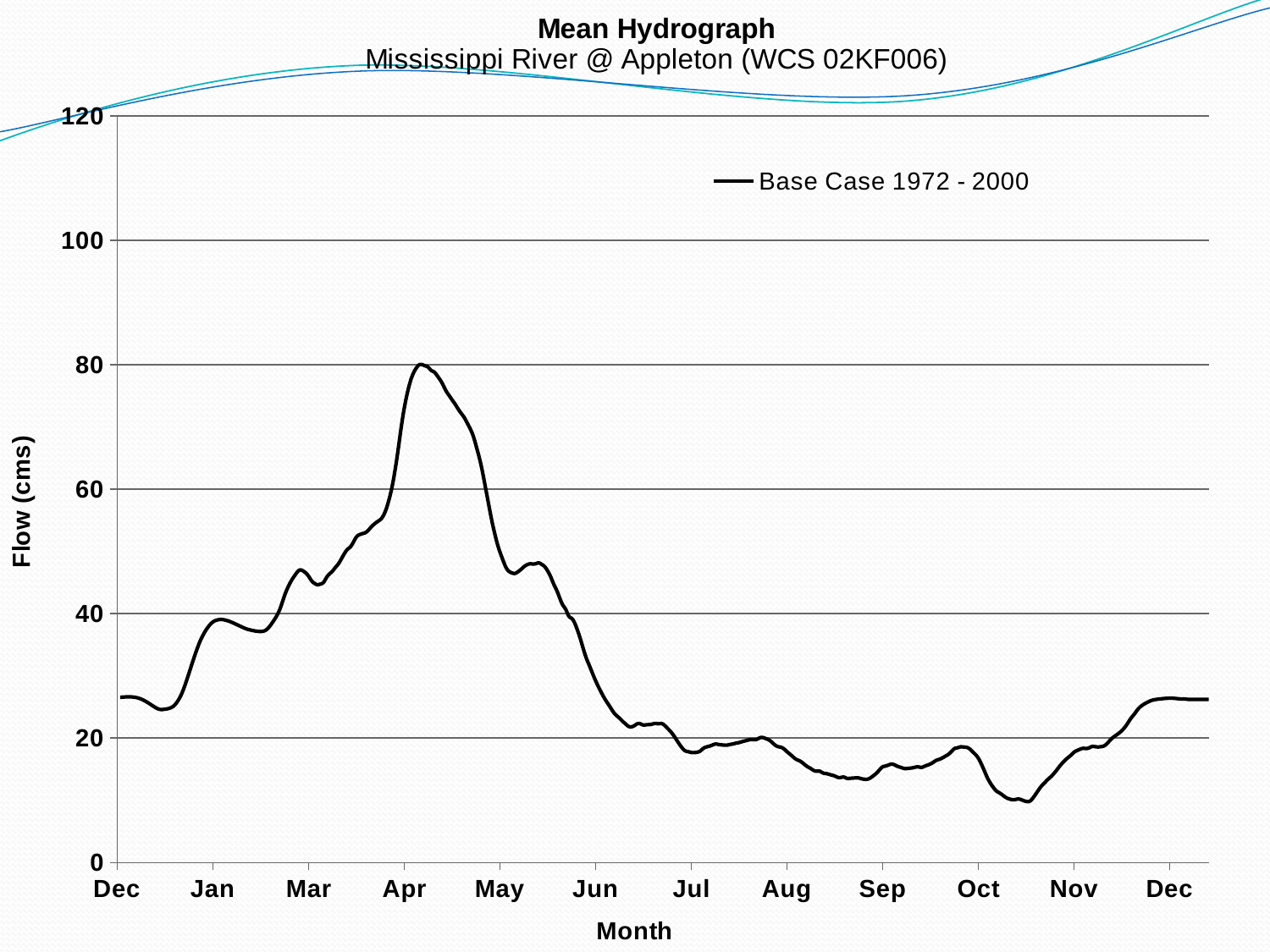
Near which month label does the flow reach its highest value? Apr Is the peak flow value in April greater or less than 100? less How many series does the legend list? 1 How many month labels are shown on the x axis? 12 Is the peak flow value in April greater or less than 60? greater Is the flow value in August greater or less than 40? less What kind of chart is shown on the slide? line chart Does the flow rise or fall between Apr and Jun? fall What is the name of the series shown in the legend? Base Case 1972 - 2000 What is the label of the y axis? Flow (cms)